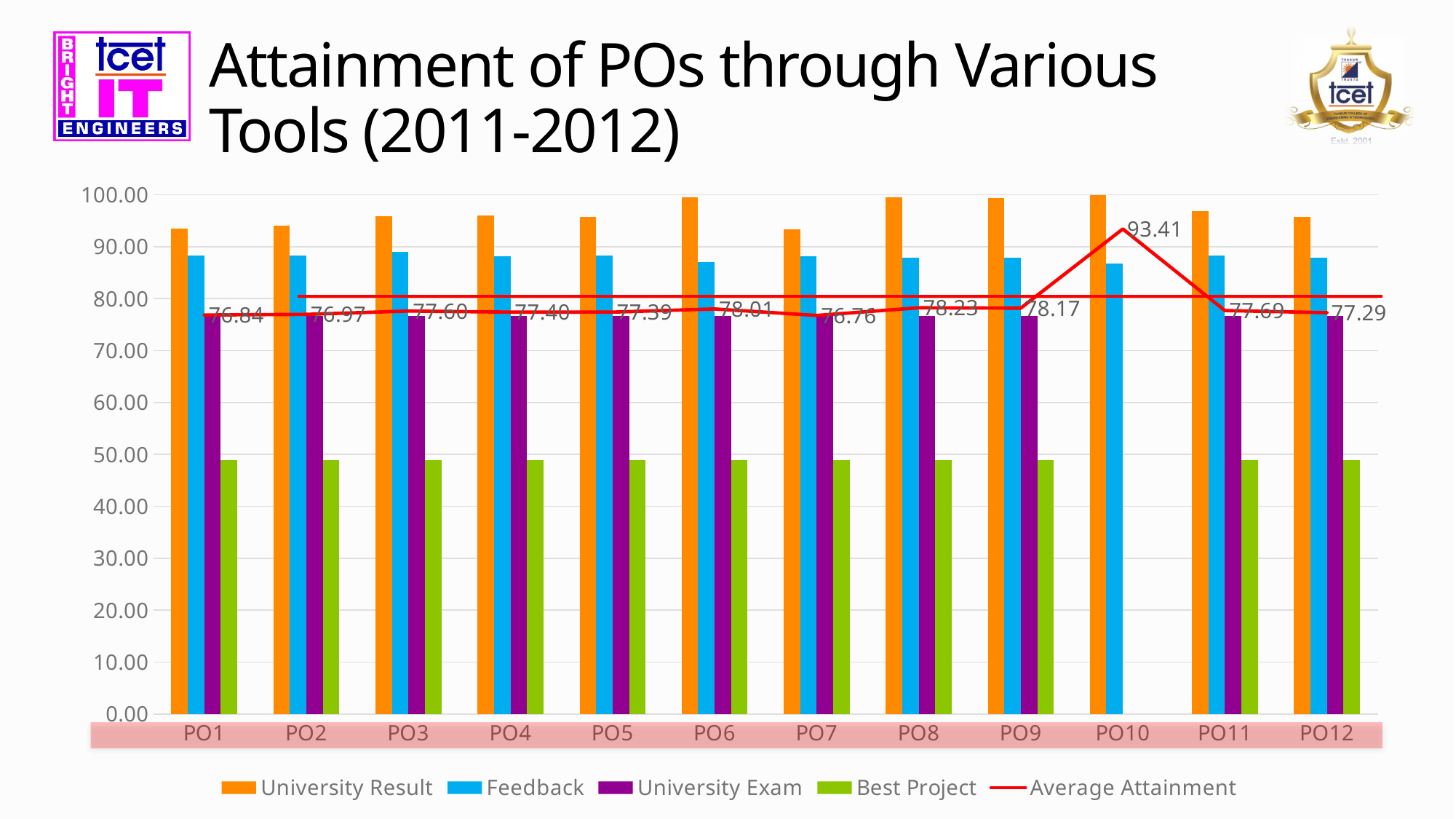
Is the Best Project value for PO1 greater or less than 50.00? less What is the Average Attainment value for PO10? 93.41 What is the difference between the Average Attainment for PO10 and PO1? 16.57 How many series does the legend list? 5 Which PO has the lowest Average Attainment? PO7 How many POs are shown on the x axis? 12 What is the Average Attainment value for PO1? 76.84 Which has a higher Average Attainment, PO6 or PO12? PO6 Is the University Result value for PO10 greater or less than 90.00? greater Which series is drawn as a red line rather than bars? Average Attainment What is the Average Attainment value for PO8? 78.23 Which PO has the highest Average Attainment? PO10